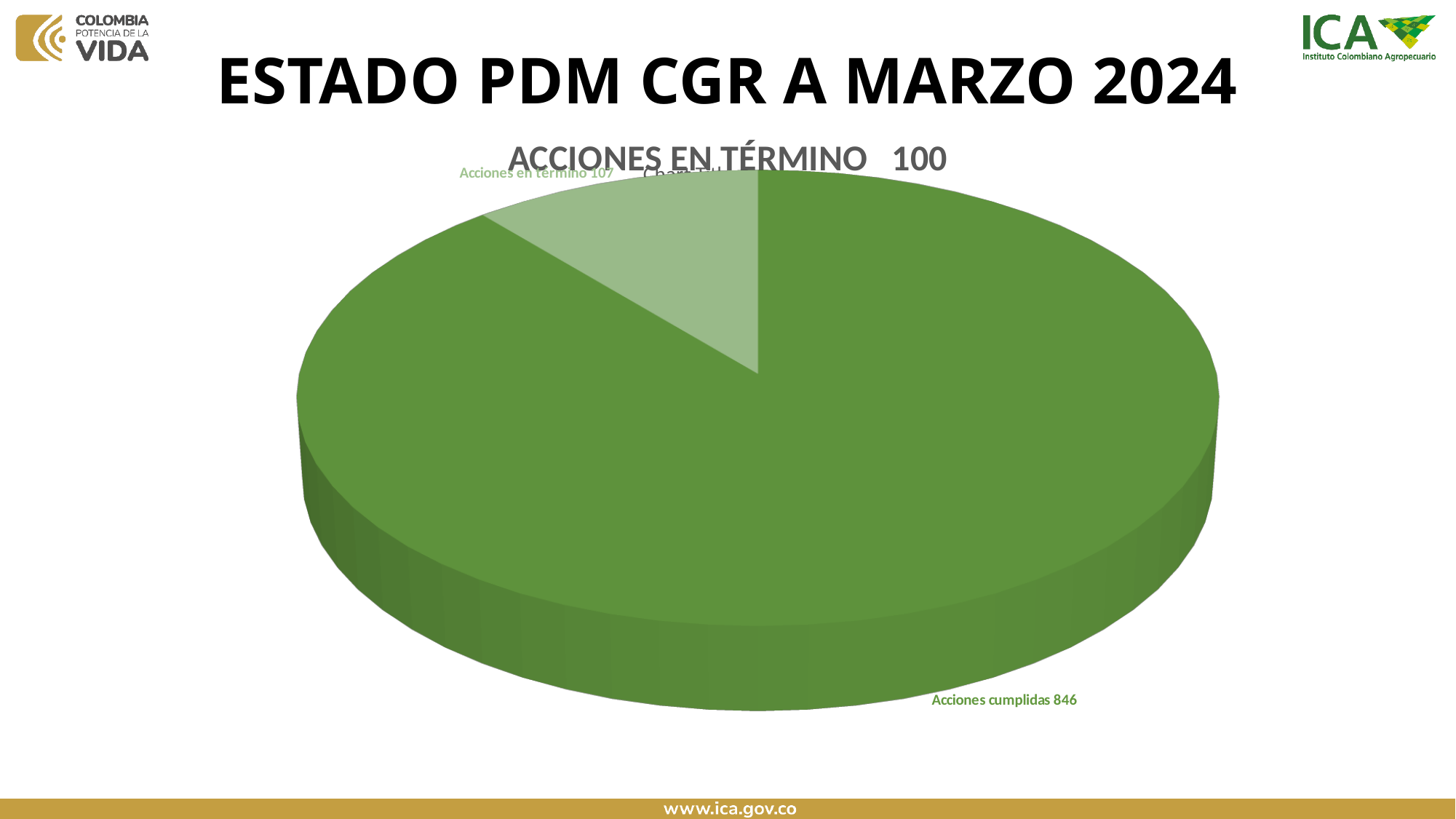
Which slice of the pie chart is the largest? Acciones cumplidas What is the total of the two slices in the pie chart? 953 What kind of chart is shown on the slide? Pie chart What is the value for Acciones en término in the pie chart? 107 What is the difference between Acciones cumplidas and Acciones en término? 739 Which slice of the pie chart is the smallest? Acciones en término What share of the pie does Acciones cumplidas represent? 88.8% Which is larger, Acciones cumplidas or Acciones en término? Acciones cumplidas What is the value for Acciones cumplidas in the pie chart? 846 How many slices does the pie chart have? 2 What is the main title of the slide above the chart? ESTADO PDM CGR A MARZO 2024 Which slice of the pie chart is drawn in the lighter green colour? Acciones en término